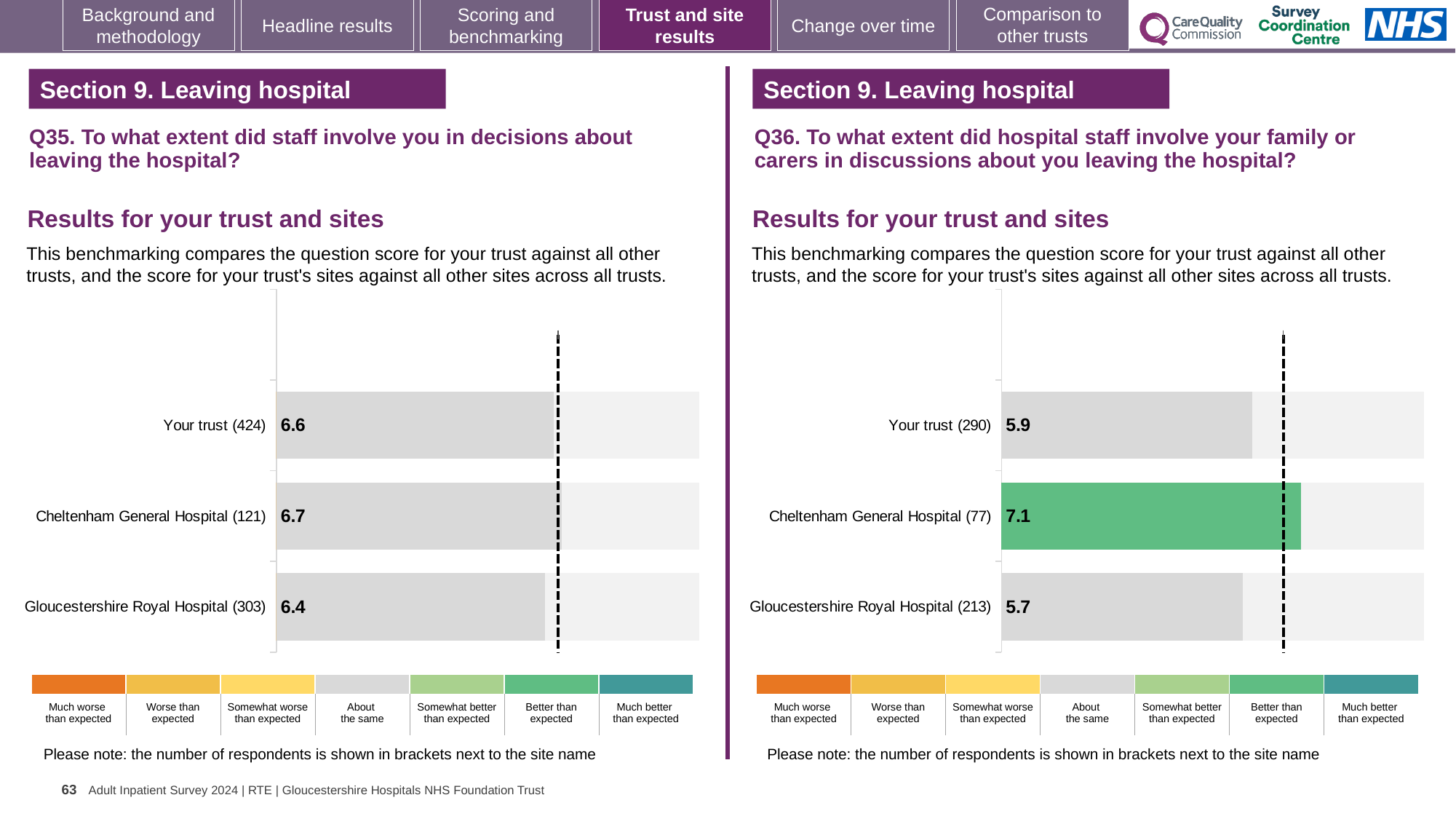
In the Q36 chart (right), what is the score for Your trust (290)? 5.9 In the Q36 chart (right), which has the larger score, Your trust (290) or Gloucestershire Royal Hospital (213)? Your trust (290) How many bars are plotted in the Q35 chart (left)? 3 In the Q36 chart (right), what is the score for Cheltenham General Hospital (77)? 7.1 In the Q36 chart (right), which benchmark category does the green colour of the Cheltenham General Hospital (77) bar represent? Better than expected In the Q35 chart (left), which site or trust has the highest score? Cheltenham General Hospital (121) In the Q35 chart (left), what is the difference between the scores for Cheltenham General Hospital (121) and Gloucestershire Royal Hospital (303)? 0.3 What kind of chart is used for the Q36 results (right)? Bar chart In the Q36 chart (right), which site or trust has the lowest score? Gloucestershire Royal Hospital (213) In the Q35 chart (left), what is the score for Gloucestershire Royal Hospital (303)? 6.4 In the Q36 chart (right), what is the difference between the scores for Cheltenham General Hospital (77) and Your trust (290)? 1.2 In the Q35 chart (left), what is the score for Your trust (424)? 6.6